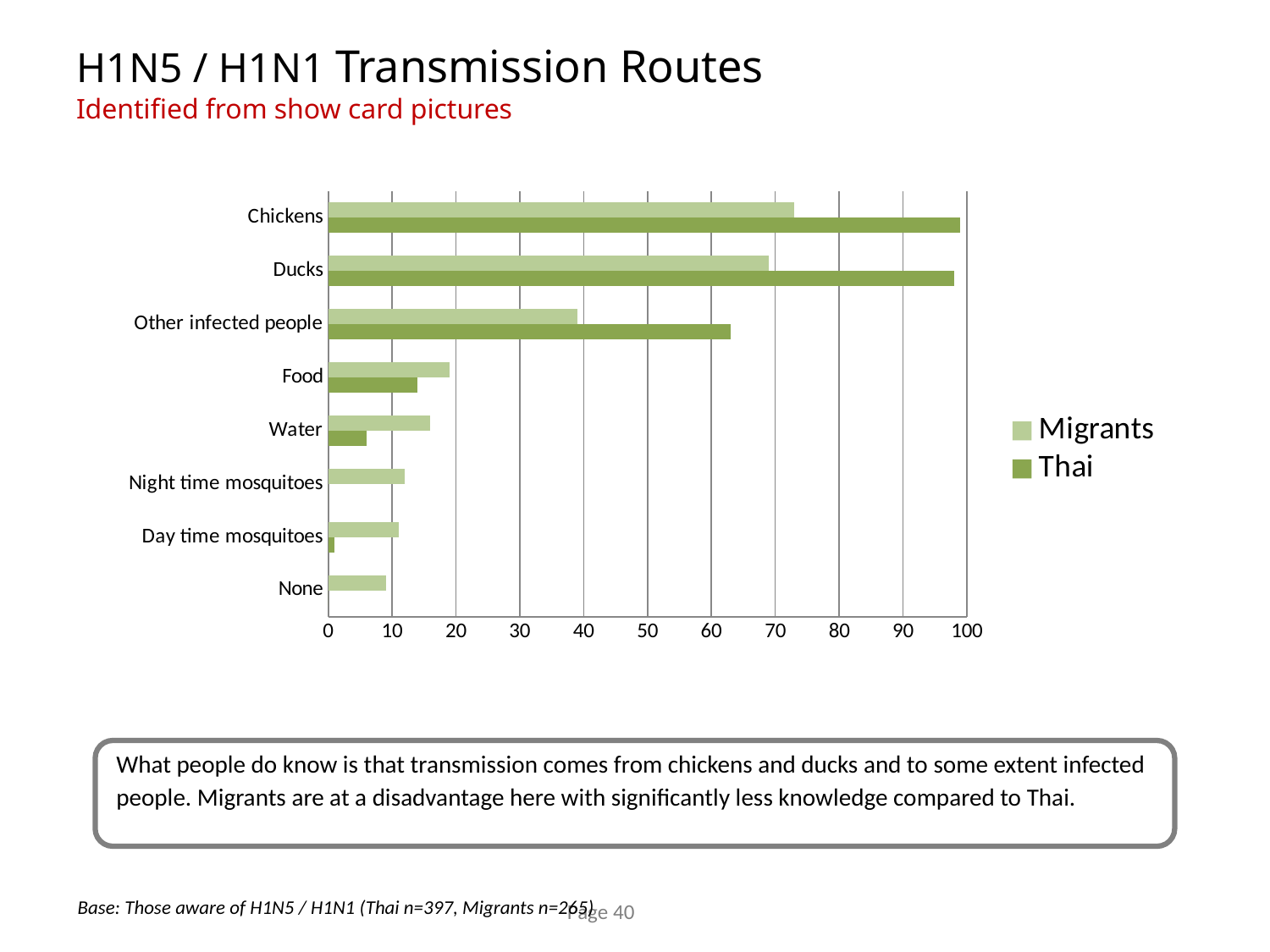
Which two groups are compared in the chart legend? Migrants and Thai How many transmission route categories are listed on the chart? 8 For Other infected people, which group has the larger value, Migrants or Thai? Thai Is the Migrants value for Ducks greater or less than 60? greater For Chickens, which group has the larger value, Migrants or Thai? Thai Is the Thai value for Other infected people greater or less than 50? greater Is the Thai value for Chickens greater or less than 90? greater What kind of chart is shown on the slide? bar chart For Food, which group has the larger value, Migrants or Thai? Migrants How many series does the legend list? 2